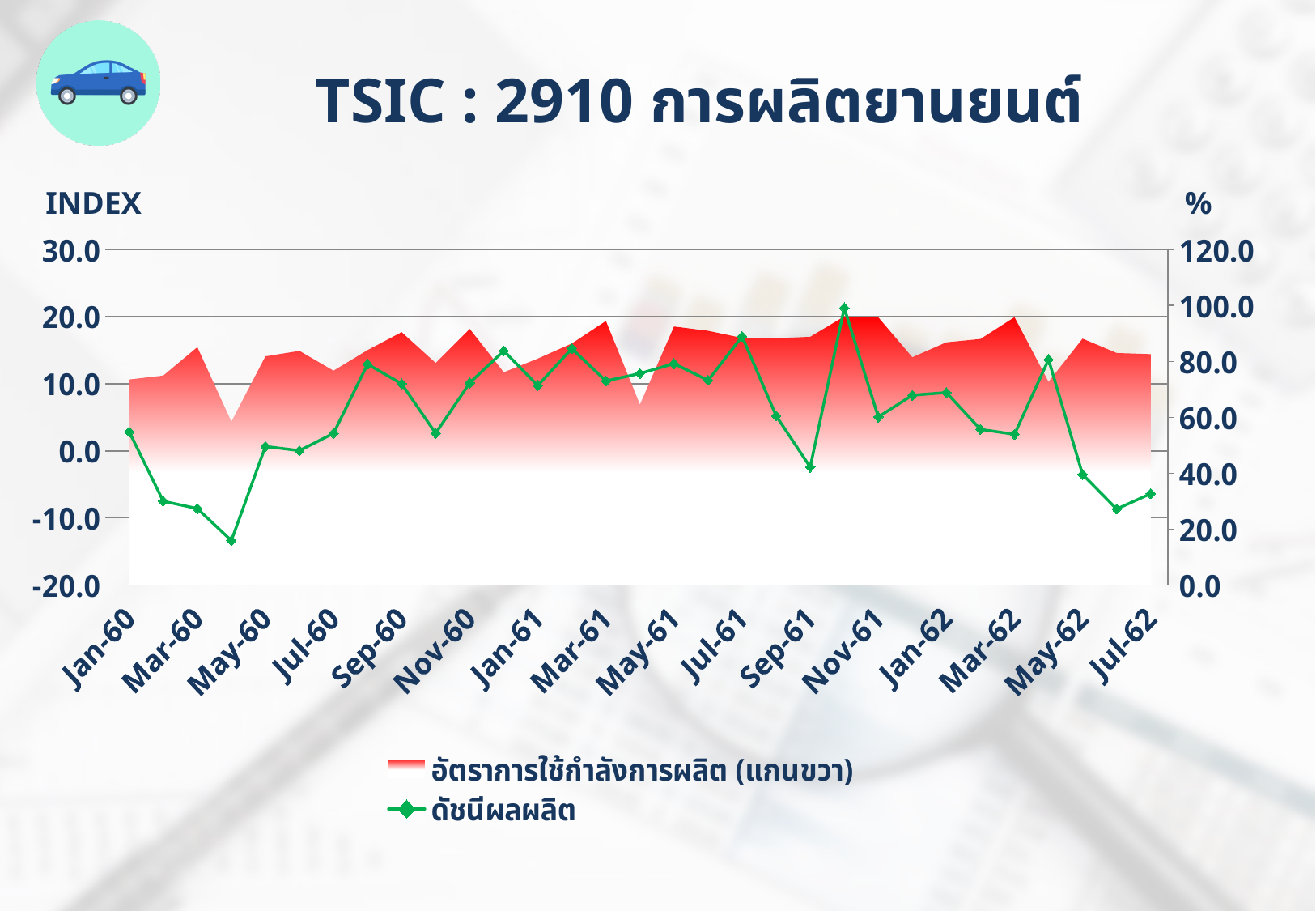
Which month has the highest value of the ดัชนีผลผลิต (green line)? Oct-61 Is the ดัชนีผลผลิต value for Mar-60 greater or less than 0.0? less Between May-62 and Jul-62, does the ดัชนีผลผลิต line rise or fall? fall Is the ดัชนีผลผลิต value for Sep-61 greater or less than 10.0? less Which series is plotted on the right axis (%) according to the legend? อัตราการใช้กำลังการผลิต (แกนขวา) What kind of chart is shown on the slide? A combination chart with an area series and a line series What is the title of the chart? TSIC : 2910 การผลิตยานยนต์ Is the อัตราการใช้กำลังการผลิต value for Nov-61 greater or less than 80.0%? greater How many series does the legend list? 2 Which is larger, the ดัชนีผลผลิต value for Nov-61 or for Jul-62? Nov-61